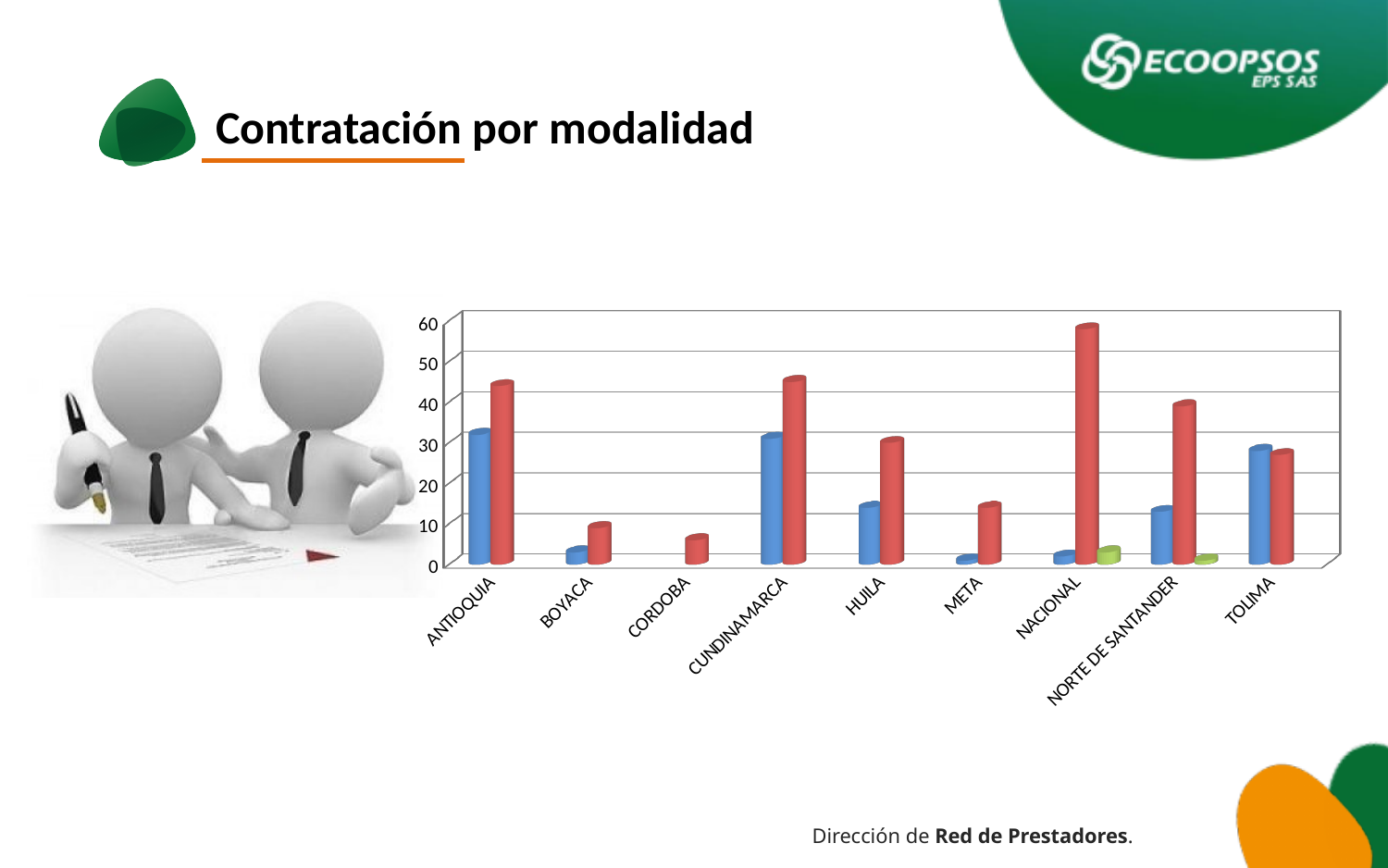
Is the red bar for META greater or less than 20? less Which category has the tallest red bar in the chart? NACIONAL Is the red bar for ANTIOQUIA greater or less than 40? greater Is the red bar for NACIONAL greater or less than 50? greater What kind of chart is shown on the slide? Bar chart For ANTIOQUIA, which is larger, the blue bar or the red bar? The red bar How many categories are shown along the x axis of the chart? 9 What is the title of the slide containing the chart? Contratación por modalidad Which is larger, the red bar for NACIONAL or the red bar for CUNDINAMARCA? NACIONAL